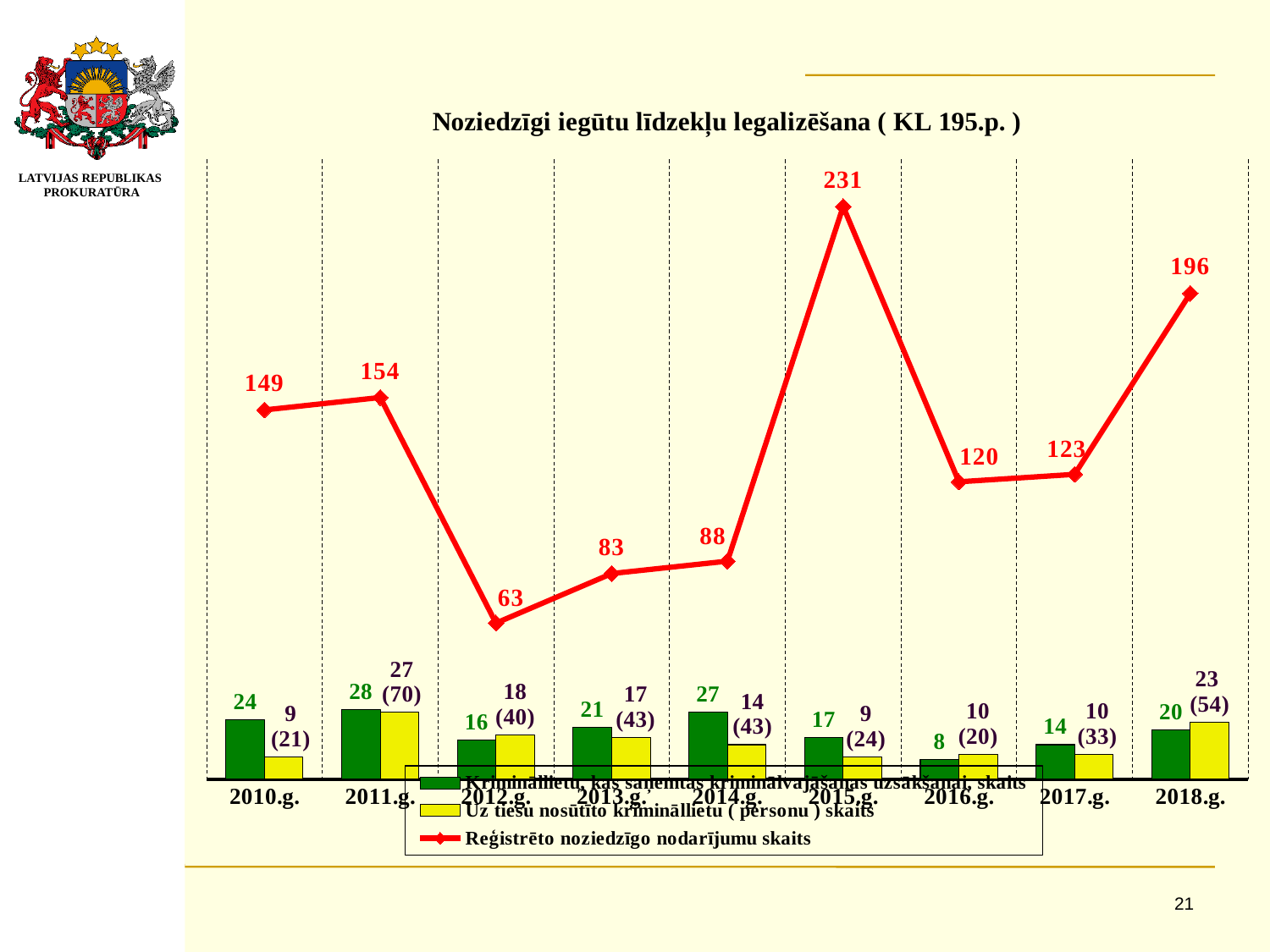
What is the value of the green bar (Krimināllietu, kas saņemtas kriminālvajāšanas uzsākšanai, skaits) for 2011.g.? 28 What is the difference between the red line values for 2015.g. and 2016.g.? 111 In which year is the red line (Reģistrēto noziedzīgo nodarījumu skaits) at its lowest value? 2012.g. In which year does the red line (Reģistrēto noziedzīgo nodarījumu skaits) reach its highest value? 2015.g. Does the red line rise or fall from 2017.g. to 2018.g.? rise What is the data label on the yellow bar (Uz tiesu nosūtīto krimināllietu (personu) skaits) for 2018.g.? 23 (54) Which is larger: the red line value for 2010.g. or for 2011.g.? 2011.g. What is the title of the chart? Noziedzīgi iegūtu līdzekļu legalizēšana ( KL 195.p. ) What is the value of the red line (Reģistrēto noziedzīgo nodarījumu skaits) for 2015.g.? 231 In which year is the green bar (Krimināllietu, kas saņemtas kriminālvajāšanas uzsākšanai, skaits) lowest? 2016.g. How many years are shown on the x axis? 9 How many series does the legend list? 3